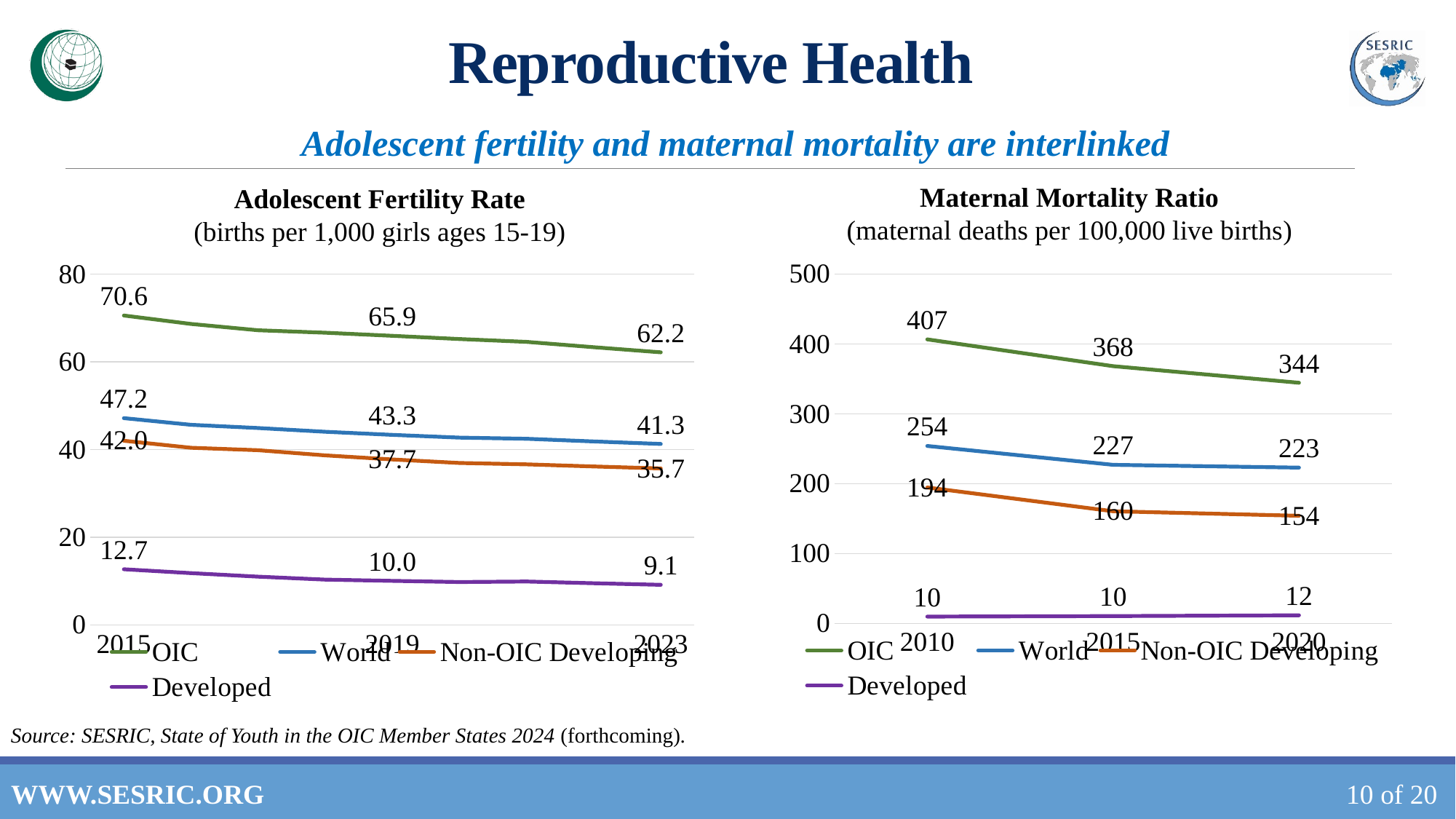
In the Adolescent Fertility Rate chart, which is larger in 2019: World or Non-OIC Developing? World In the Adolescent Fertility Rate chart, what is the difference between the OIC values in 2015 and 2023? 8.4 What kind of chart is the Adolescent Fertility Rate chart? Line chart How many series does the legend of the Maternal Mortality Ratio chart list? 4 In the Maternal Mortality Ratio chart, what is the difference between OIC and World in 2020? 121 In the Adolescent Fertility Rate chart, which series has the lowest value in 2019? Developed In the Adolescent Fertility Rate chart, what is the value for OIC in 2015? 70.6 In the Adolescent Fertility Rate chart, what is the value for Developed in 2023? 9.1 In the Maternal Mortality Ratio chart, which series has the highest value in 2010? OIC In the Maternal Mortality Ratio chart, what is the value for Non-OIC Developing in 2020? 154 In the Maternal Mortality Ratio chart, what is the value for World in 2015? 227 In the Maternal Mortality Ratio chart, does the OIC series rise or fall from 2010 to 2020? Fall